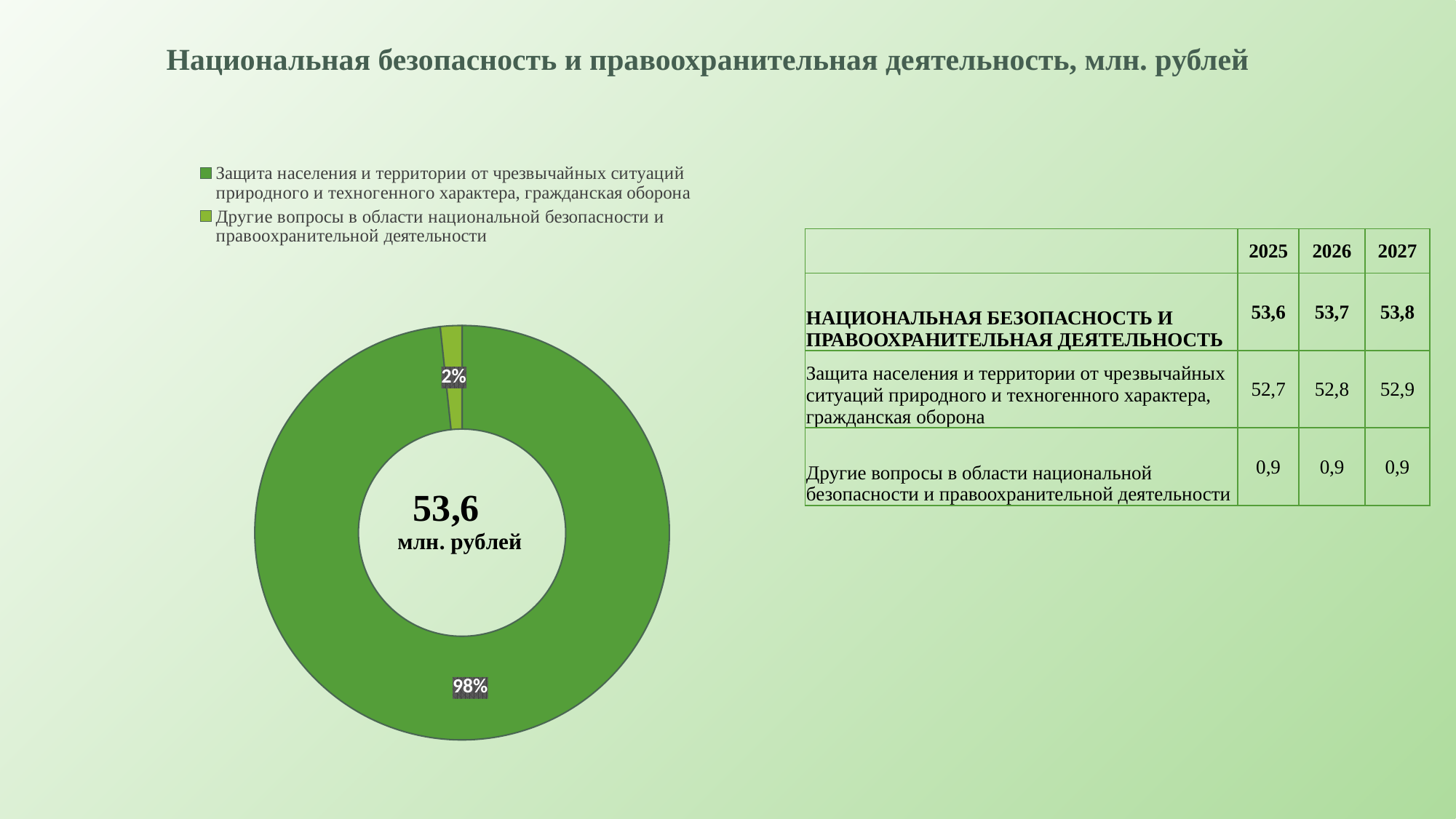
What colour is the slice labelled 2% in the doughnut chart? Light green What share of the doughnut chart is labelled for "Защита населения и территории от чрезвычайных ситуаций природного и техногенного характера, гражданская оборона"? 98% Which category has the largest slice in the doughnut chart? Защита населения и территории от чрезвычайных ситуаций природного и техногенного характера, гражданская оборона What total value is printed in the centre of the doughnut chart? 53,6 млн. рублей What share of the doughnut chart is labelled for "Другие вопросы в области национальной безопасности и правоохранительной деятельности"? 2% How many slices does the doughnut chart have? 2 What is the title of the slide containing the chart? Национальная безопасность и правоохранительная деятельность, млн. рублей What is the difference in percentage points between the two slices of the doughnut chart? 96 percentage points How many series does the chart legend list? 2 entries (categories) What kind of chart is shown on the slide? Doughnut (pie) chart Which category has the smallest slice in the doughnut chart? Другие вопросы в области национальной безопасности и правоохранительной деятельности Which slice is larger: "Защита населения и территории..." or "Другие вопросы..."? Защита населения и территории от чрезвычайных ситуаций природного и техногенного характера, гражданская оборона